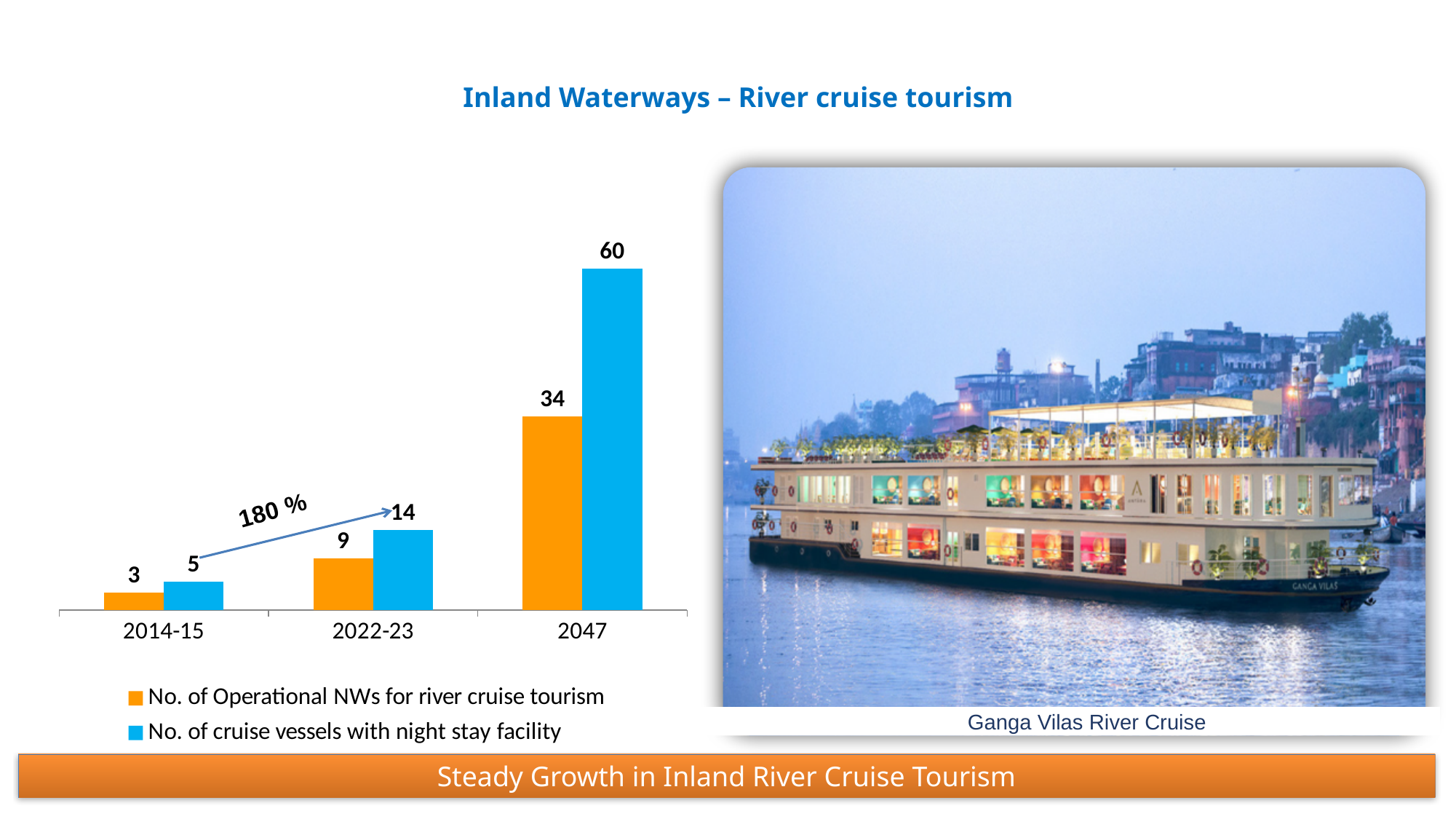
In 2022-23, which is larger: the number of operational NWs for river cruise tourism or the number of cruise vessels with night stay facility? No. of cruise vessels with night stay facility Do the values for the number of operational NWs for river cruise tourism rise or fall from 2014-15 to 2047? Rise What is the difference between the number of cruise vessels with night stay facility in 2047 and in 2022-23? 46 Which year has the highest number of operational NWs for river cruise tourism? 2047 What is the number of cruise vessels with night stay facility in 2047? 60 What kind of chart is shown on the slide? Bar chart What is the number of cruise vessels with night stay facility in 2014-15? 5 What percentage growth is annotated on the arrow between 2014-15 and 2022-23 in the chart? 180 % What is the number of operational NWs for river cruise tourism in 2022-23? 9 How many series does the chart legend list? 2 How many year categories are shown on the x axis of the chart? 3 Which year has the lowest number of cruise vessels with night stay facility? 2014-15